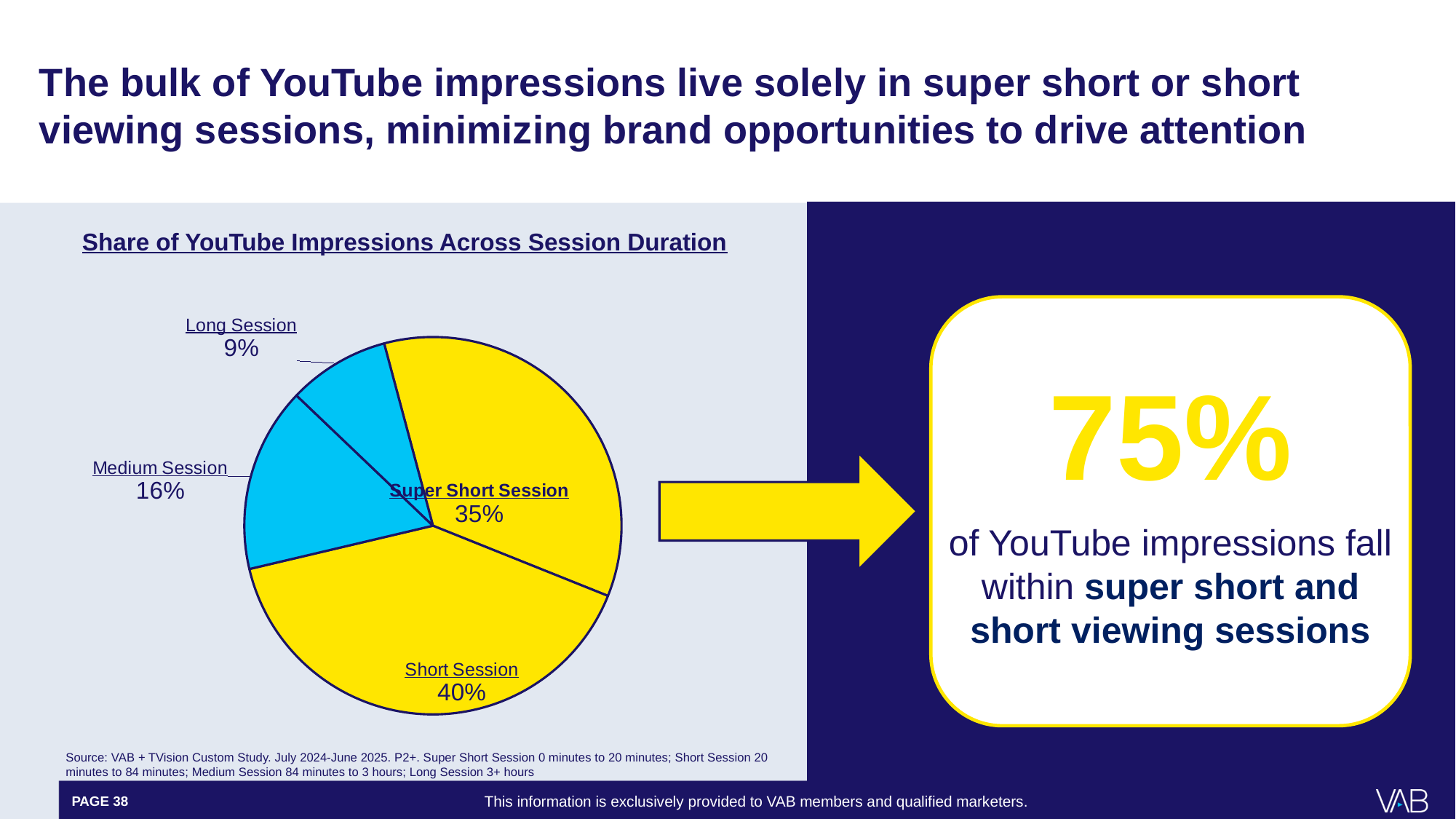
What type of chart is shown on the slide? Pie chart Which has a larger share of impressions, Medium Session or Long Session? Medium Session What is the difference in share between Short Session and Super Short Session? 5% What is the combined share of Super Short Session and Short Session? 75% What share of YouTube impressions falls in the Short Session category? 40% What share of YouTube impressions falls in the Medium Session category? 16% Which session duration category has the largest share of YouTube impressions? Short Session What is the title of the pie chart? Share of YouTube Impressions Across Session Duration How many session duration categories are shown in the pie chart? 4 What share of YouTube impressions falls in the Super Short Session category? 35% Which session duration category has the smallest share of YouTube impressions? Long Session What share of YouTube impressions falls in the Long Session category? 9%